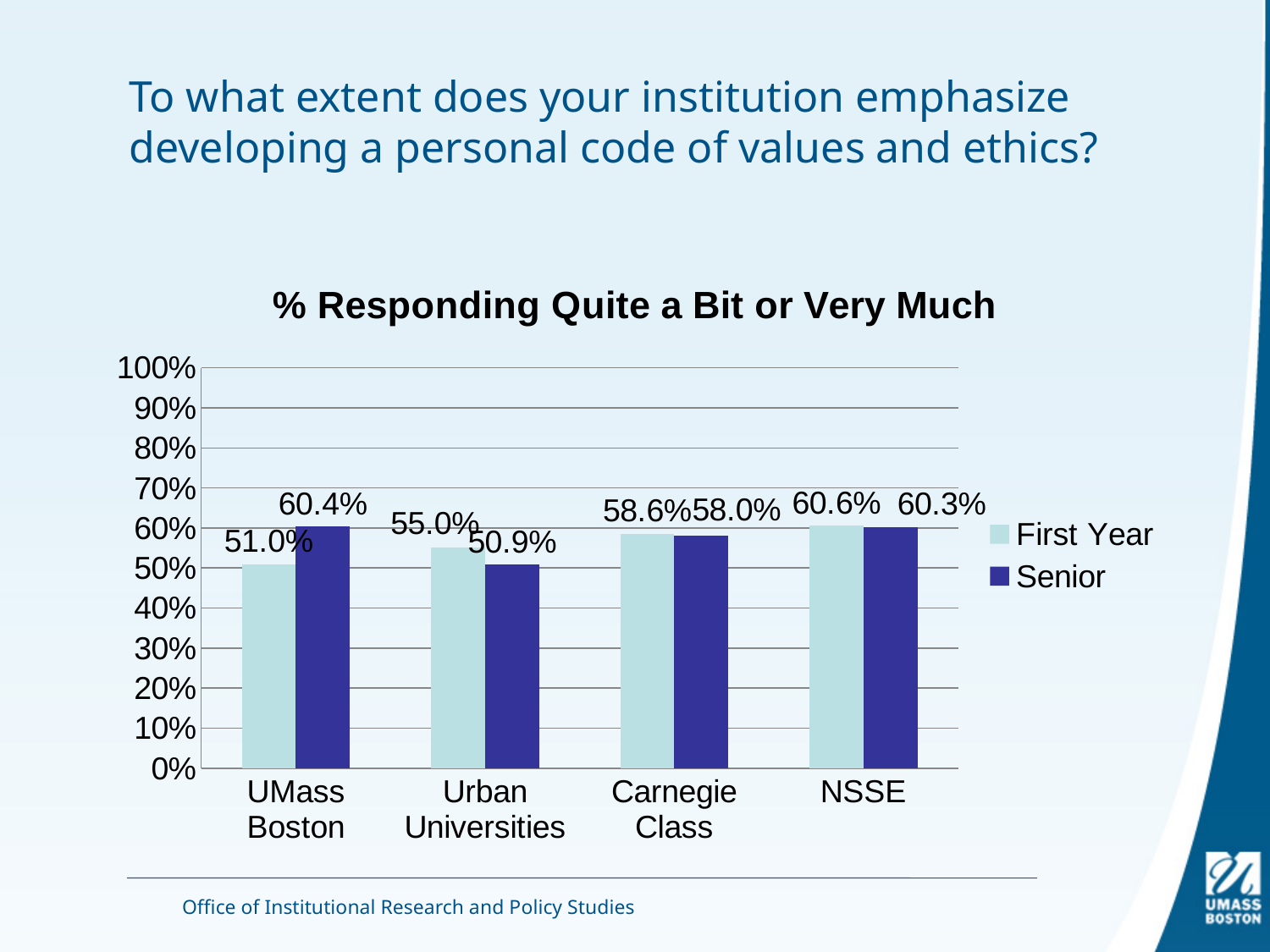
What is the title of the chart? % Responding Quite a Bit or Very Much What kind of chart is shown on the slide? Bar chart What is the difference between the Senior and First Year values for UMass Boston? 9.4% Which category has the highest First Year value? NSSE What is the Senior value for Urban Universities? 50.9% Which category has the lowest First Year value? UMass Boston Which is larger for Urban Universities, the First Year value or the Senior value? First Year How many series does the legend list? 2 How many categories are shown on the x axis? 4 What is the Senior value for NSSE? 60.3% What is the First Year value for UMass Boston? 51.0% Which category has the lowest Senior value? Urban Universities